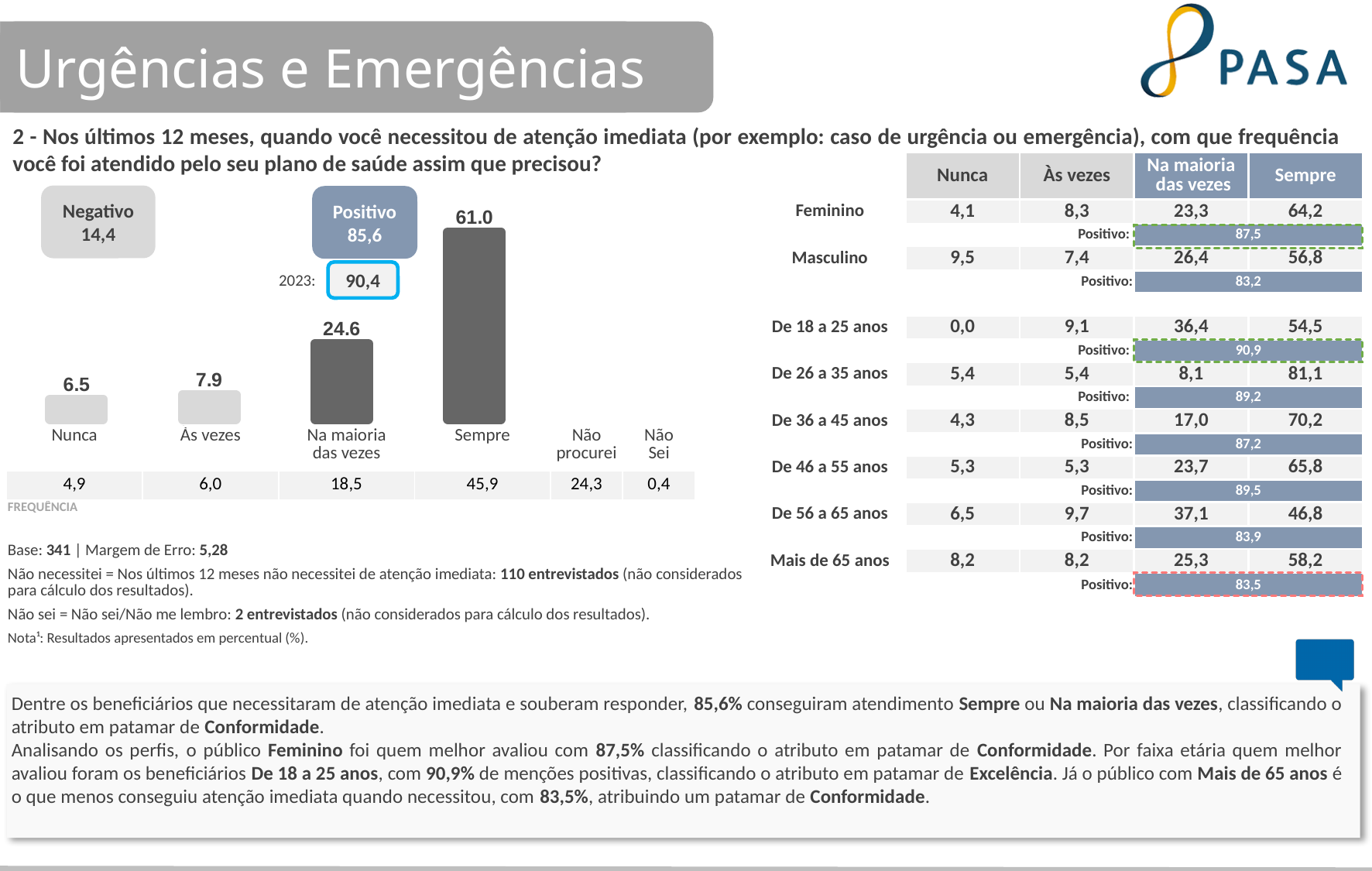
What is the value of the bar for "Na maioria das vezes" in the bar chart? 24.6 What value is shown in the "Positivo" box above the bar chart? 85,6 Which category has the highest bar in the bar chart? Sempre How many bars are plotted in the bar chart? 4 What is the difference between the values for "Às vezes" and "Nunca" in the bar chart? 1.4 What type of chart is shown on the slide? Bar chart Which category has the lowest bar in the bar chart? Nunca What is the value of the bar for "Nunca" in the bar chart? 6.5 What is the value of the bar for "Sempre" in the bar chart? 61.0 What is the difference between the values for "Sempre" and "Na maioria das vezes" in the bar chart? 36.4 What is the value of the bar for "Às vezes" in the bar chart? 7.9 Which is larger in the bar chart, the value for "Às vezes" or the value for "Nunca"? Às vezes